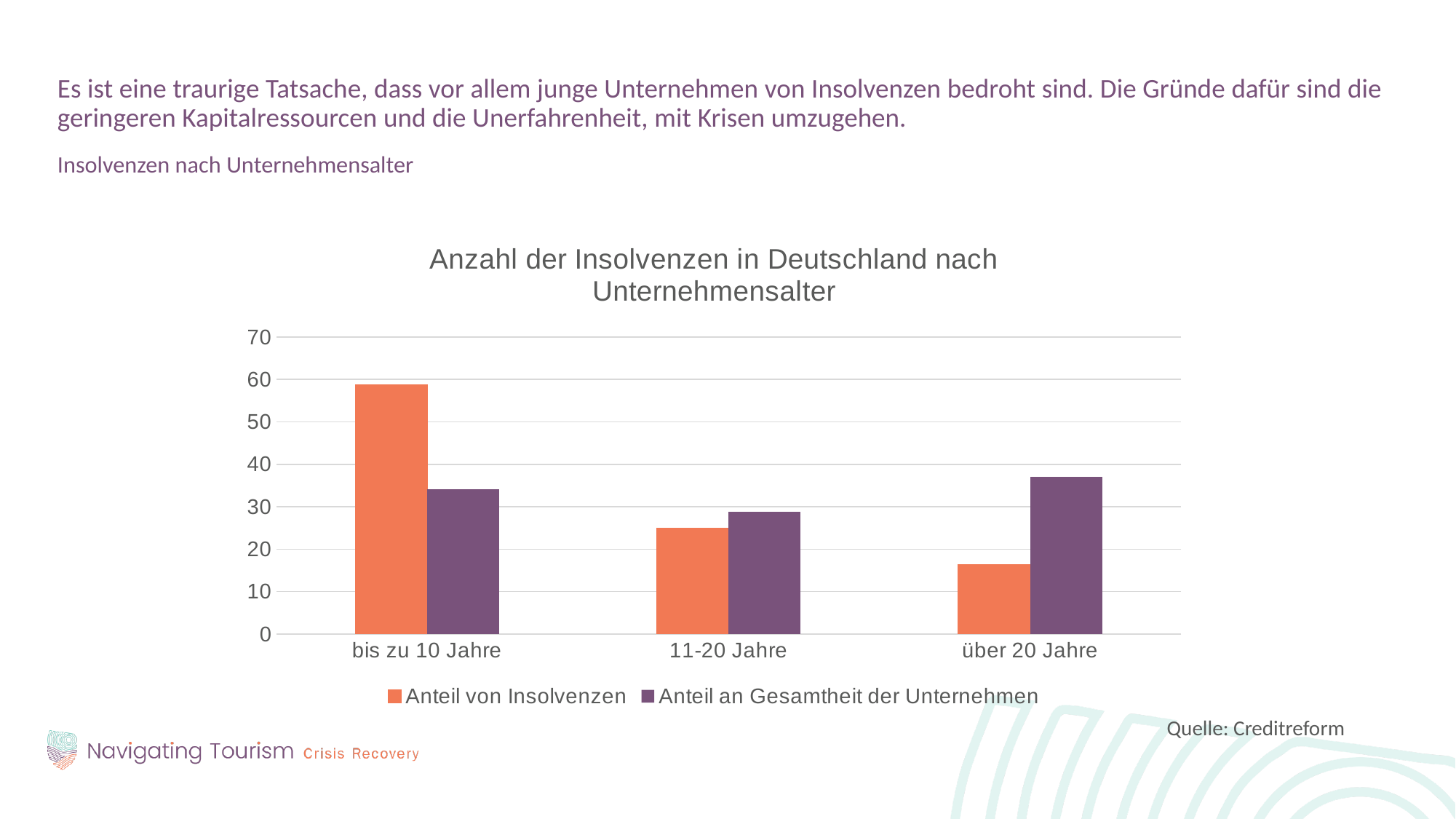
Is the value for Anteil an Gesamtheit der Unternehmen in the category über 20 Jahre greater or less than 30? greater What kind of chart is shown on the slide? bar chart Which category has the highest value for Anteil an Gesamtheit der Unternehmen? über 20 Jahre Which category has the highest value for Anteil von Insolvenzen? bis zu 10 Jahre How many age categories are shown on the x axis? 3 How many series does the legend list? 2 Do the values for Anteil von Insolvenzen rise or fall from bis zu 10 Jahre to über 20 Jahre? fall In the category 11-20 Jahre, which series has the larger value: Anteil von Insolvenzen or Anteil an Gesamtheit der Unternehmen? Anteil an Gesamtheit der Unternehmen Is the value for Anteil von Insolvenzen in the category bis zu 10 Jahre greater or less than 50? greater What is the title of the chart? Anzahl der Insolvenzen in Deutschland nach Unternehmensalter Which category has the lowest value for Anteil von Insolvenzen? über 20 Jahre Is the value for Anteil von Insolvenzen in the category über 20 Jahre greater or less than 20? less